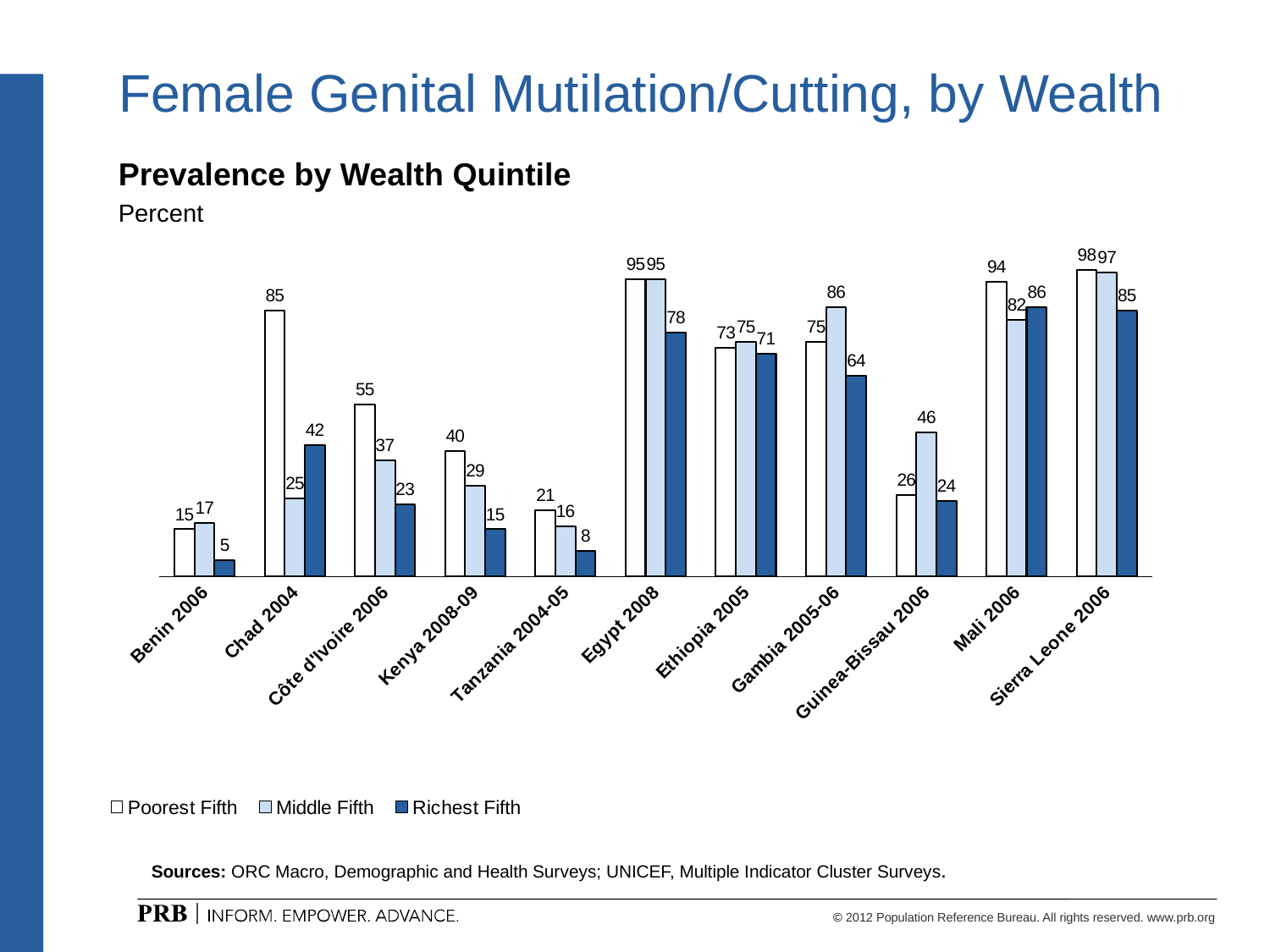
What is the Richest Fifth value for Gambia 2005-06? 64 Which country has the highest Poorest Fifth value? Sierra Leone 2006 What is the Poorest Fifth value for Chad 2004? 85 What is the difference between the Poorest Fifth and Middle Fifth values for Chad 2004? 60 Which is larger for Mali 2006: the Middle Fifth value or the Richest Fifth value? Richest Fifth How many countries are shown on the x axis? 11 How many series does the legend list? 3 What is the difference between the Middle Fifth and Richest Fifth values for Egypt 2008? 17 Which country has the lowest Richest Fifth value? Benin 2006 What is the Middle Fifth value for Guinea-Bissau 2006? 46 What kind of chart is shown on the slide? Bar chart What are the three series listed in the legend? Poorest Fifth, Middle Fifth, Richest Fifth